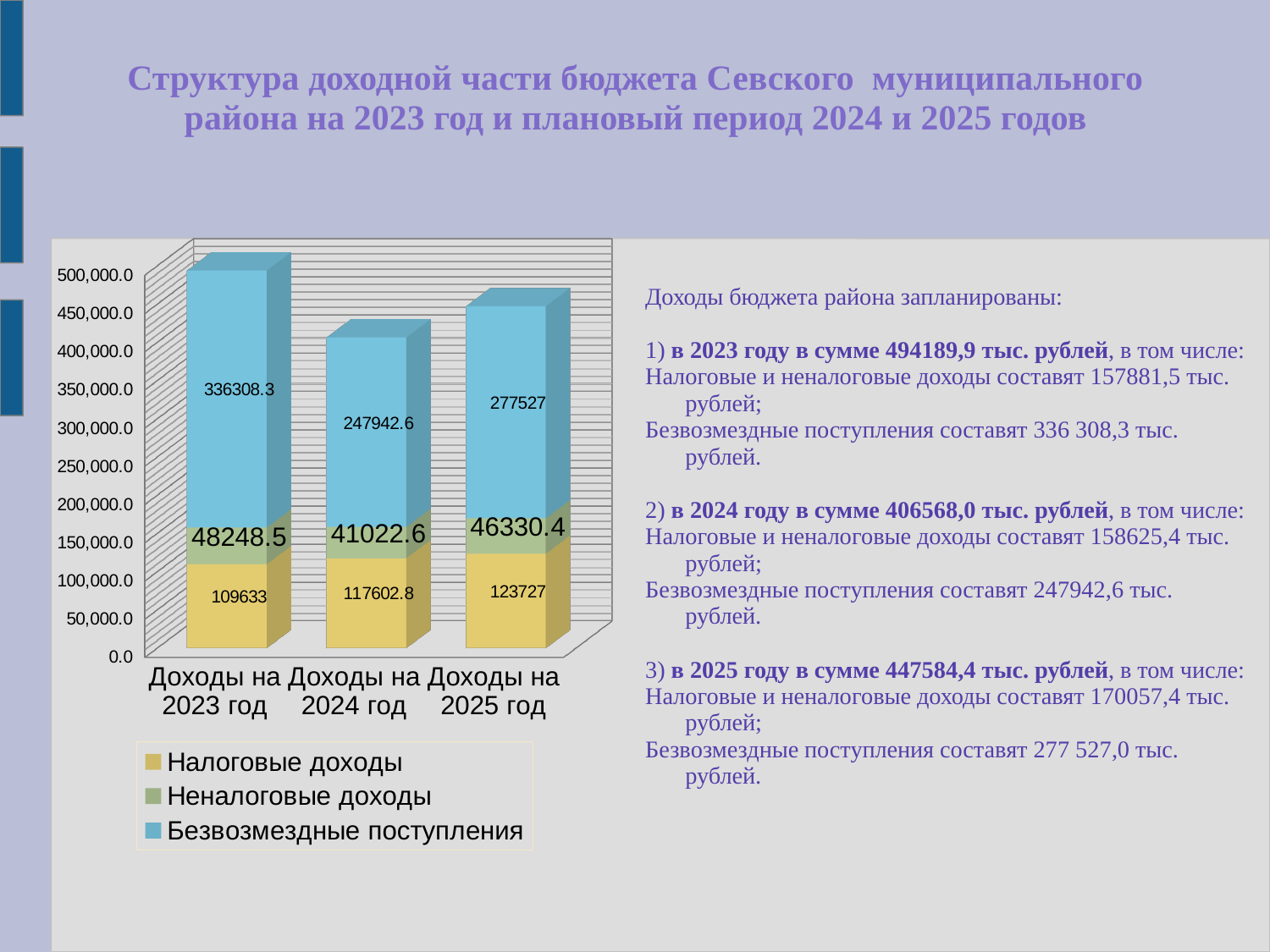
What type of chart is shown on the slide? Stacked bar chart In which year is the Безвозмездные поступления value the lowest? Доходы на 2024 год What is the difference between Безвозмездные поступления in 2023 (336308.3) and in 2024 (247942.6)? 88365.7 What is the value of Налоговые доходы for Доходы на 2024 год? 117602.8 What is the total of the stacked bar for Доходы на 2024 год? 406568.0 How many categories (years) are shown on the x axis of the chart? 3 Which is larger: Неналоговые доходы for 2023 or for 2024? 2023 (48248.5) What is the value of Неналоговые доходы for Доходы на 2025 год? 46330.4 What is the value of Безвозмездные поступления for Доходы на 2023 год? 336308.3 Which series is shown in blue in the chart legend? Безвозмездные поступления How many series does the chart legend list? 3 In which year is the Налоговые доходы value the highest? Доходы на 2025 год